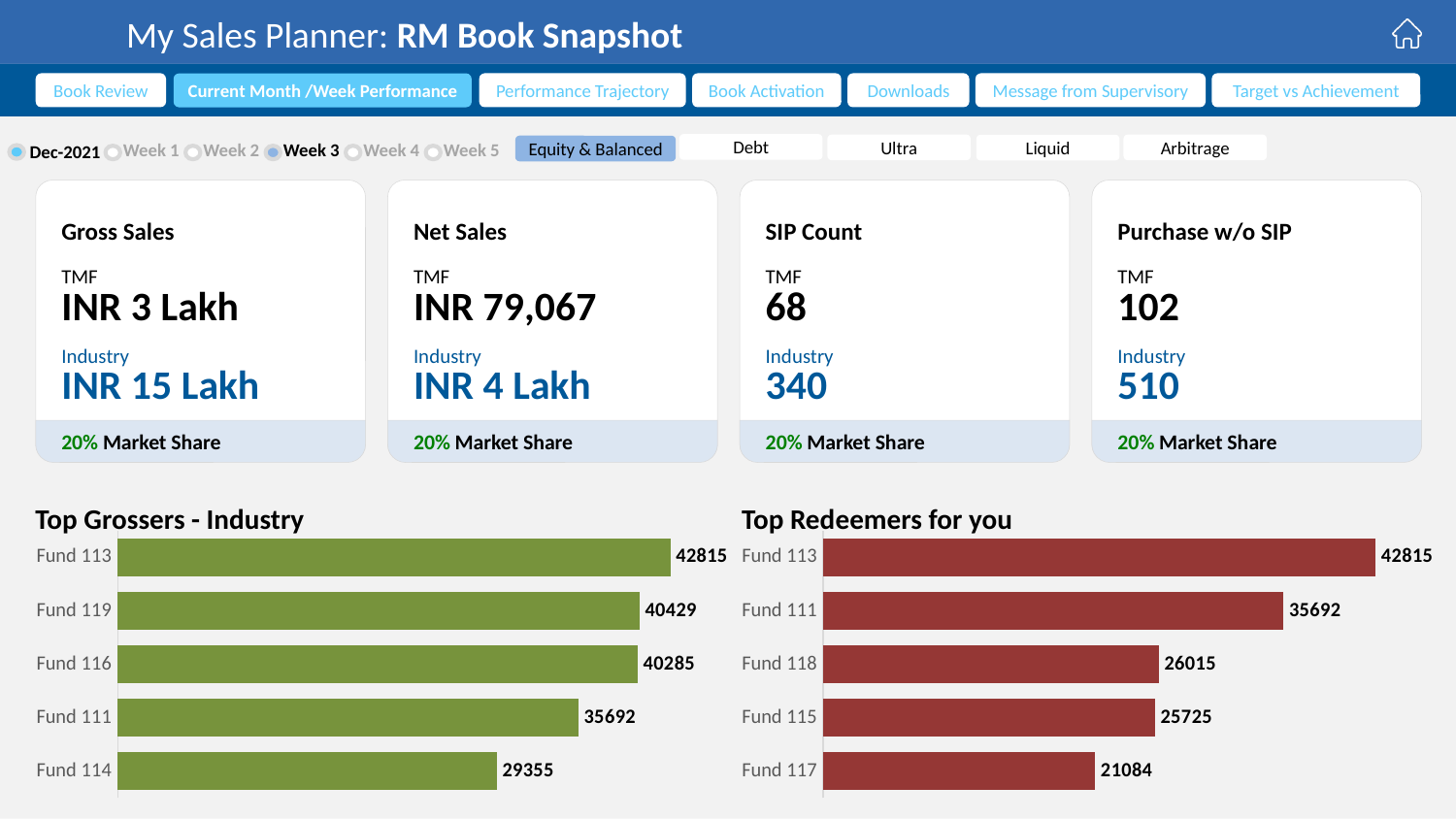
In the 'Top Grossers - Industry' chart, which fund has the highest value? Fund 113 In the 'Top Grossers - Industry' chart, which is larger, the value for Fund 111 or the value for Fund 114? Fund 111 What kind of chart is 'Top Redeemers for you'? Bar chart In the 'Top Grossers - Industry' chart, what is the difference between the values for Fund 113 and Fund 114? 13460 In the 'Top Redeemers for you' chart, what is the value for Fund 118? 26015 What colour are the bars in the 'Top Grossers - Industry' chart? Green How many funds are shown in the 'Top Grossers - Industry' chart? 5 In the 'Top Redeemers for you' chart, what is the difference between the values for Fund 111 and Fund 115? 9967 In the 'Top Grossers - Industry' chart, what is the value for Fund 119? 40429 In the 'Top Redeemers for you' chart, which is larger, the value for Fund 118 or the value for Fund 117? Fund 118 In the 'Top Redeemers for you' chart, do the values rise or fall from the top bar to the bottom bar? Fall In the 'Top Redeemers for you' chart, which fund has the lowest value? Fund 117